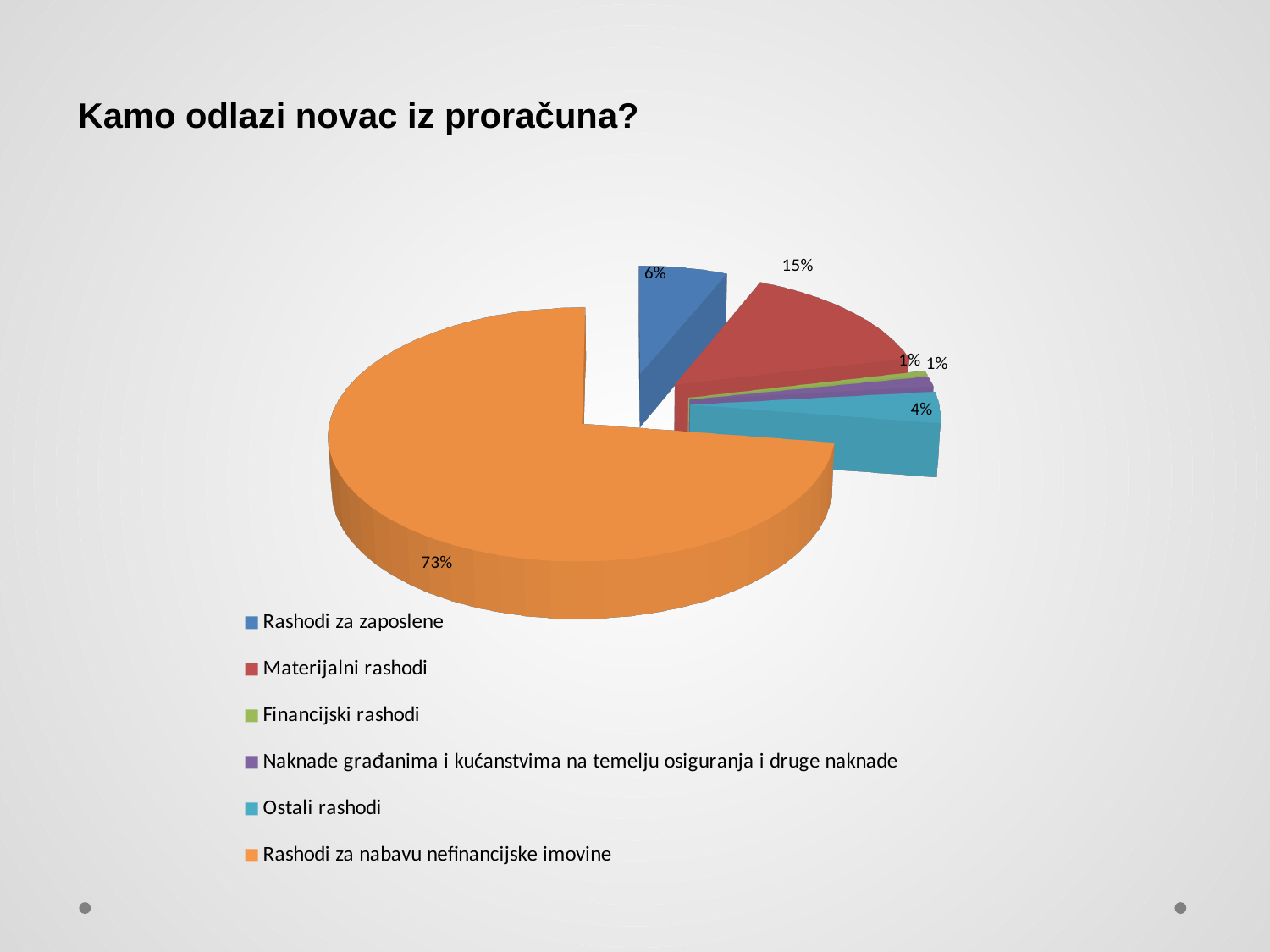
What share of the pie is Rashodi za nabavu nefinancijske imovine? 73% Which is larger, Materijalni rashodi or Rashodi za zaposlene? Materijalni rashodi How many categories does the legend list? 6 What is the value for Financijski rashodi? 1% What type of chart is shown on the slide? pie chart Which category has the largest share of the pie? Rashodi za nabavu nefinancijske imovine What is the value for Rashodi za zaposlene? 6% What colour is the slice for Rashodi za nabavu nefinancijske imovine? orange What is the difference between Materijalni rashodi and Ostali rashodi? 11% What is the value for Materijalni rashodi? 15% What is the title of the slide? Kamo odlazi novac iz proračuna? What is the value for Ostali rashodi? 4%